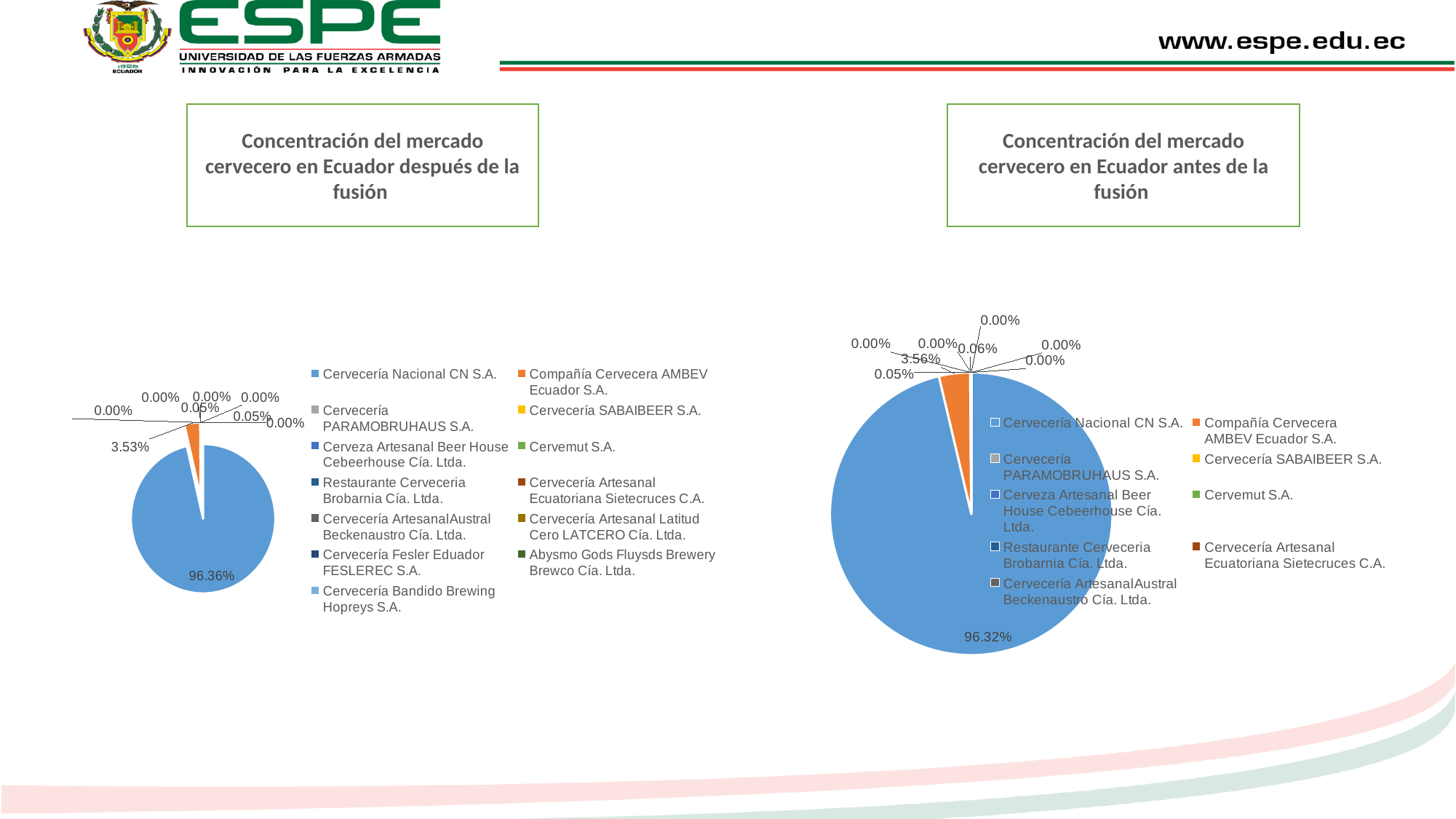
What type of chart is used on this slide? Pie chart In the chart 'Concentración del mercado cervecero en Ecuador antes de la fusión', what share does Compañía Cervecera AMBEV Ecuador S.A. hold? 3.56% In the chart 'Concentración del mercado cervecero en Ecuador después de la fusión', what share does Compañía Cervecera AMBEV Ecuador S.A. hold? 3.53% In the chart 'Concentración del mercado cervecero en Ecuador después de la fusión', what is the difference between the shares of Cervecería Nacional CN S.A. and Compañía Cervecera AMBEV Ecuador S.A.? 92.83% In the chart 'Concentración del mercado cervecero en Ecuador después de la fusión', which company has the largest slice? Cervecería Nacional CN S.A. How many companies are listed in the legend of the chart 'Concentración del mercado cervecero en Ecuador después de la fusión'? 13 Which is larger: the share of Cervecería Nacional CN S.A. in the 'después de la fusión' chart or in the 'antes de la fusión' chart? después de la fusión (96.36%) In the chart 'Concentración del mercado cervecero en Ecuador antes de la fusión', what is the difference between the shares of Cervecería Nacional CN S.A. and Compañía Cervecera AMBEV Ecuador S.A.? 92.76% In the chart 'Concentración del mercado cervecero en Ecuador después de la fusión', what share does Cervecería Nacional CN S.A. hold? 96.36% In the chart 'Concentración del mercado cervecero en Ecuador antes de la fusión', which company has the largest slice? Cervecería Nacional CN S.A. In the chart 'Concentración del mercado cervecero en Ecuador antes de la fusión', what share does Cervecería Nacional CN S.A. hold? 96.32% How many companies are listed in the legend of the chart 'Concentración del mercado cervecero en Ecuador antes de la fusión'? 9